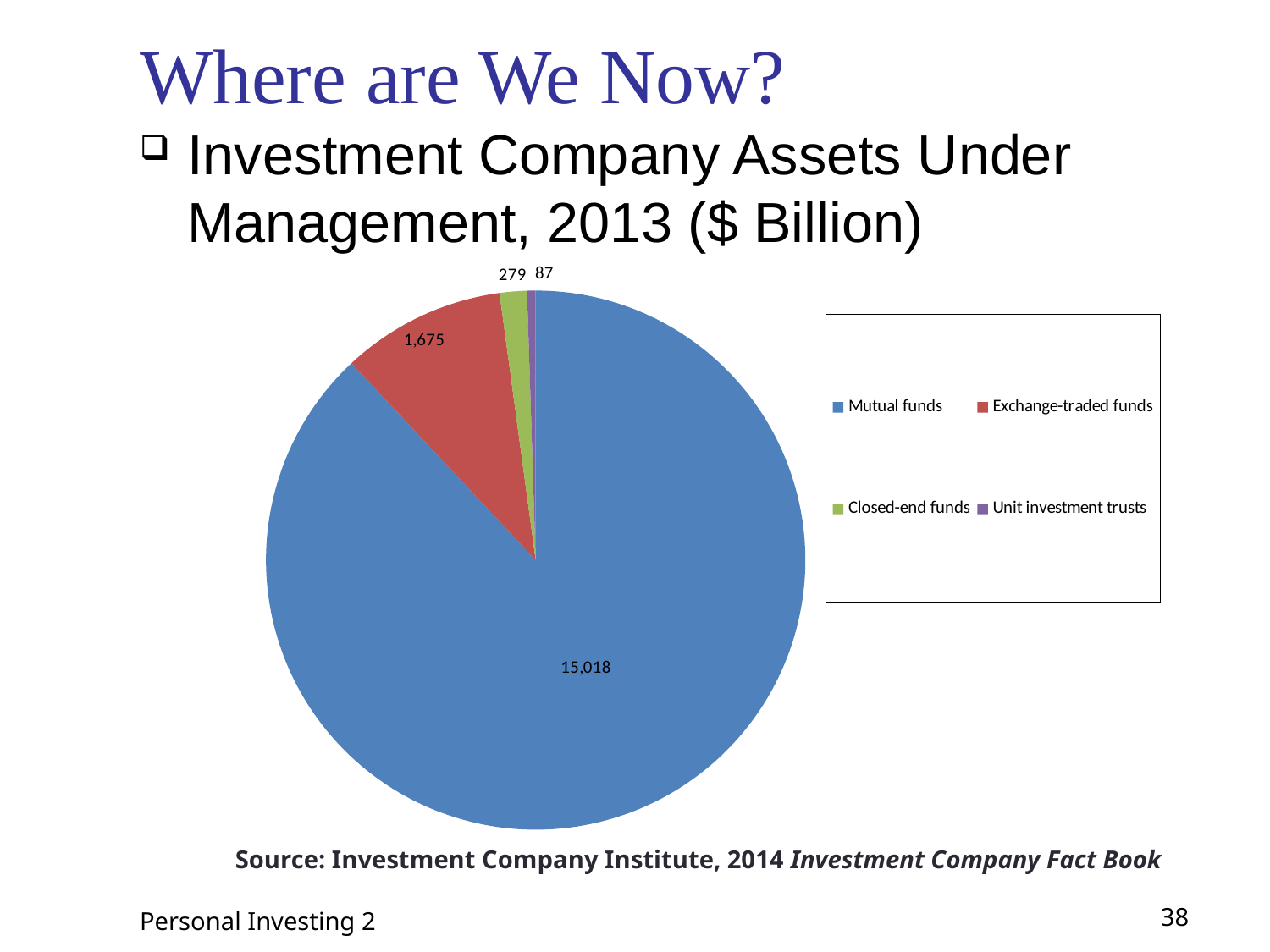
What is the value for Mutual funds? 15,018 What colour is the slice for Exchange-traded funds? Red What is the difference between the values for Mutual funds and Exchange-traded funds? 13,343 Which category has the largest slice of the pie? Mutual funds How many categories does the pie chart show? 4 Which is larger, the value for Exchange-traded funds or the value for Closed-end funds? Exchange-traded funds What is the value for Closed-end funds? 279 What is the difference between the values for Closed-end funds and Unit investment trusts? 192 What is the value for Unit investment trusts? 87 What type of chart is shown on the slide? Pie chart What is the value for Exchange-traded funds? 1,675 Which category has the smallest slice of the pie? Unit investment trusts